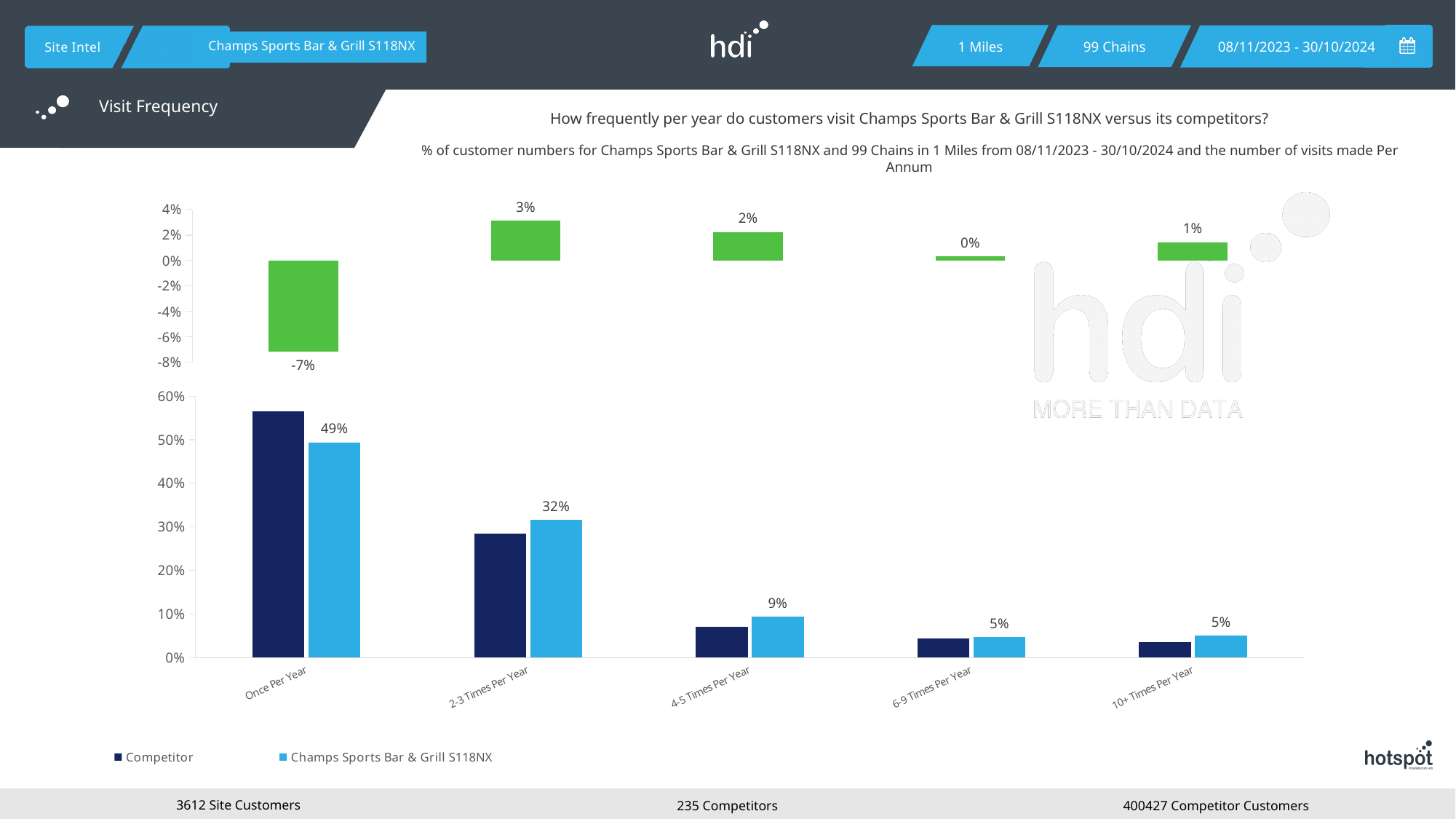
How many categories are shown on the x axis of the bottom chart? 5 In the bottom chart, for Once Per Year, which series has the larger value: Competitor or Champs Sports Bar & Grill S118NX? Competitor What kind of chart is the bottom chart? Bar chart In the bottom chart, is the Competitor value for Once Per Year greater or less than 50%? greater How many series does the legend of the bottom chart list? 2 In the bottom chart, what is the difference between the Champs Sports Bar & Grill S118NX values for Once Per Year and 2-3 Times Per Year? 17% In the top chart, what is the value shown for 2-3 Times Per Year? 3% In the top chart, which category has the lowest value? Once Per Year In the top chart, which category has the highest value? 2-3 Times Per Year In the top chart, what is the value shown for Once Per Year? -7% In the bottom chart, what is the value for Champs Sports Bar & Grill S118NX in the 2-3 Times Per Year category? 32% In the bottom chart, what is the value for Champs Sports Bar & Grill S118NX in the Once Per Year category? 49%